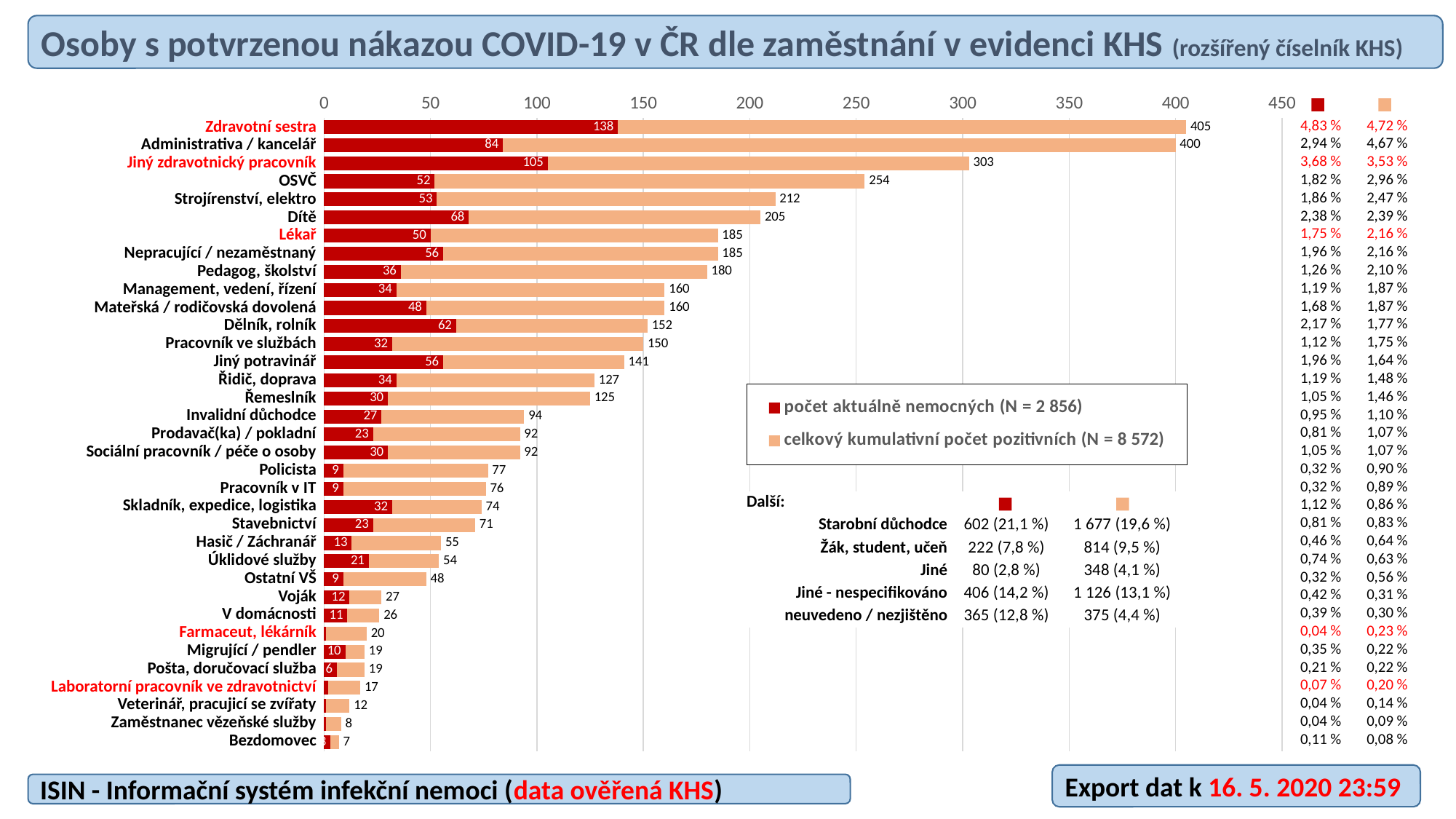
What type of chart is shown on the slide? bar chart Which has more currently ill persons: Dítě or Dělník, rolník? Dítě What is the difference between the cumulative positive cases for Zdravotní sestra and Administrativa / kancelář? 5 How many currently ill (počet aktuálně nemocných) are shown for Jiný zdravotnický pracovník? 105 Is the cumulative number of positive cases for OSVČ greater or less than 250? greater What is the cumulative number of positive cases (celkový kumulativní počet pozitivních) for Zdravotní sestra? 405 Which occupation has the highest cumulative number of positive cases? Zdravotní sestra What is the difference between the number of currently ill for Zdravotní sestra and for Administrativa / kancelář? 54 How many series does the chart legend list? 2 Which occupation has the lowest cumulative number of positive cases? Bezdomovec How many occupation categories are plotted in the bar chart? 35 What is the cumulative number of positive cases for Pedagog, školství? 180